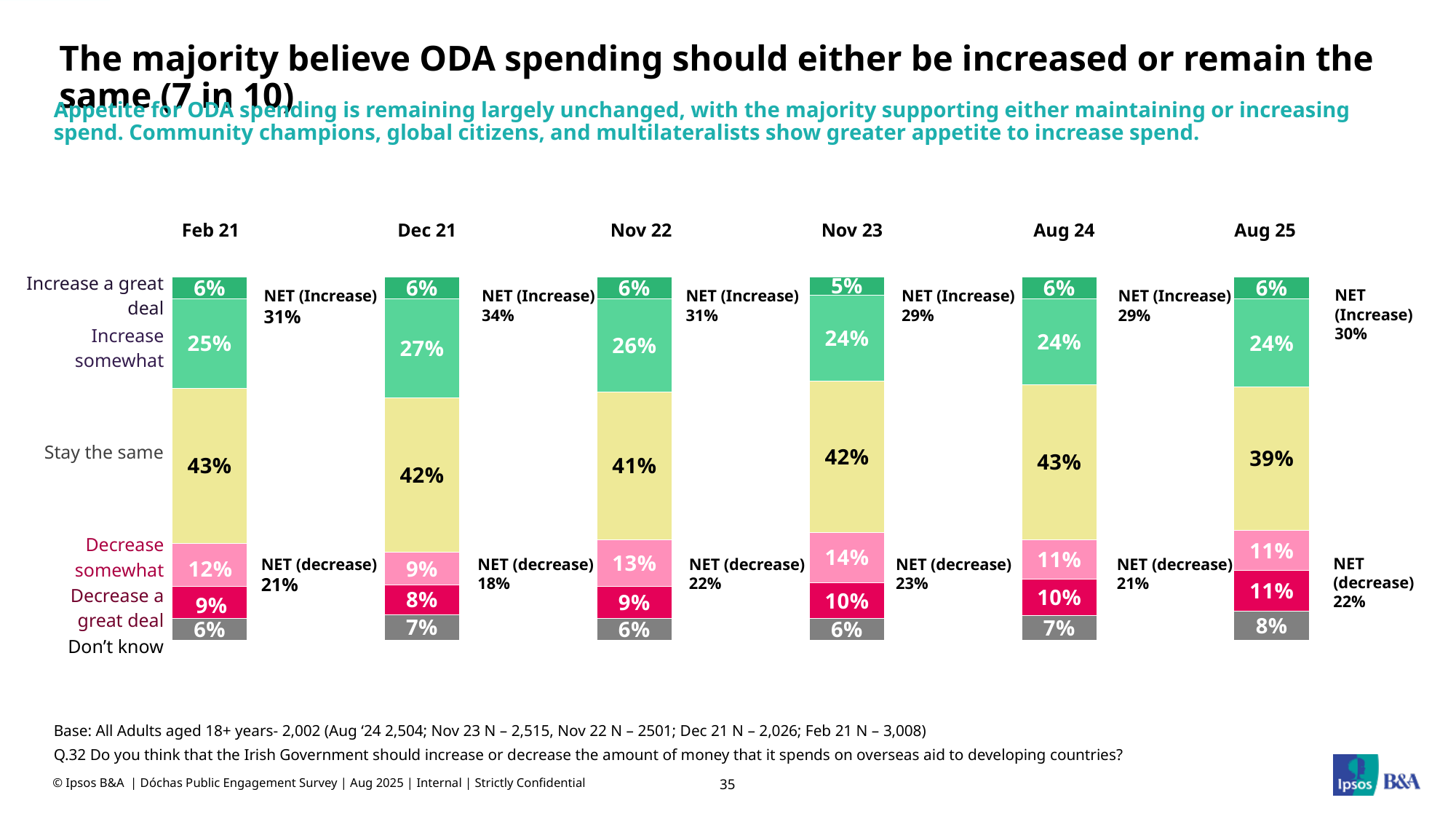
What percentage said 'Increase somewhat' in Dec 21? 27% In which period is the 'Stay the same' share lowest? Aug 25 How many survey periods are shown in the chart? 6 By how many percentage points does 'Stay the same' differ between Feb 21 and Aug 25? 4 percentage points What is the NET (decrease) figure for Nov 23? 23% What is the NET (Increase) figure for Dec 21? 34% What is the 'Don't know' value for Aug 25? 8% What percentage said 'Stay the same' in Aug 25? 39% In which period is the 'Decrease somewhat' share highest? Nov 23 Which period has the larger 'Increase somewhat' share, Dec 21 or Nov 23? Dec 21 What kind of chart is shown on the slide? Stacked bar chart Does the 'Don't know' share rise or fall from Nov 23 to Aug 25? Rises